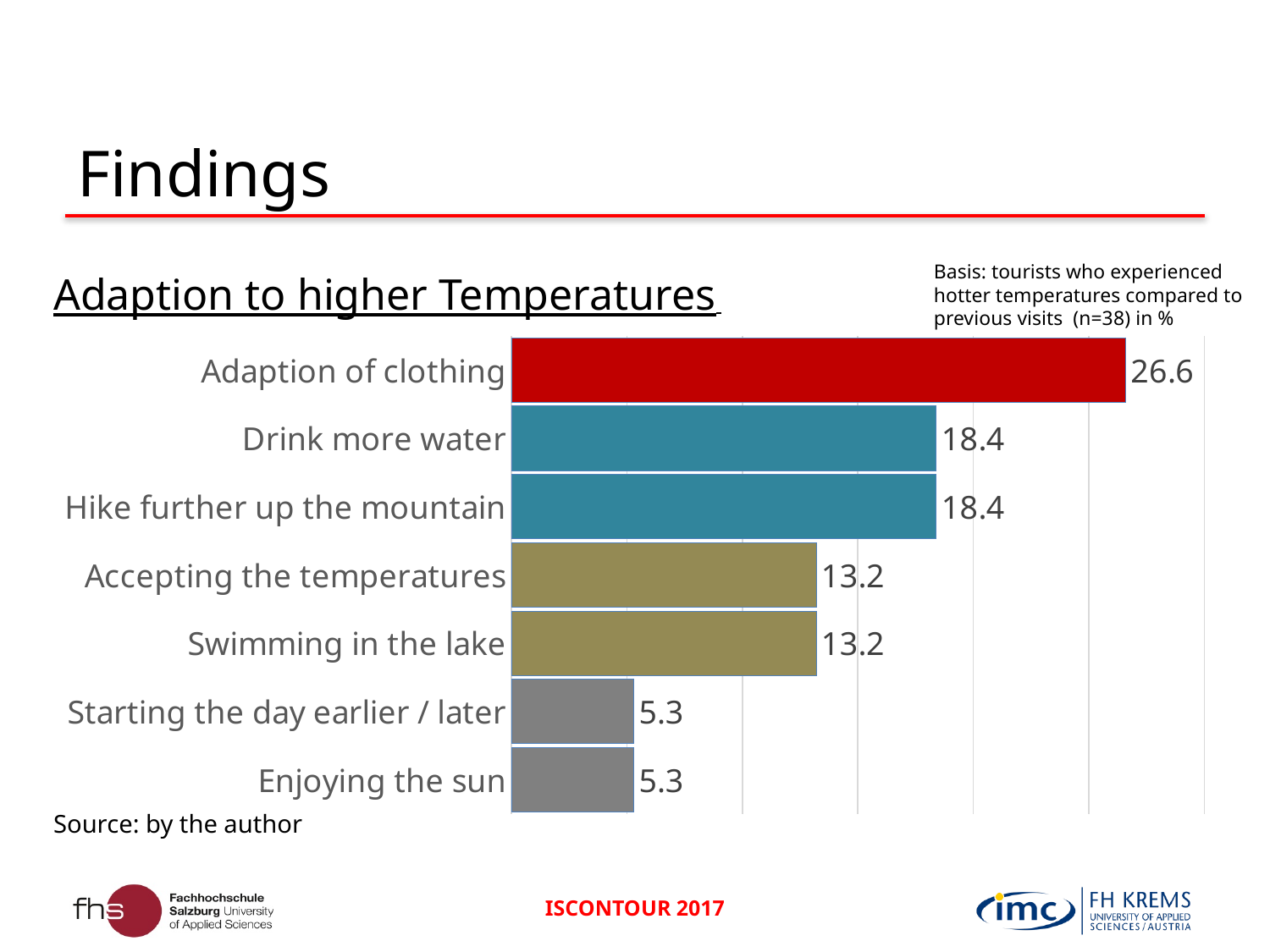
What kind of chart is shown on the slide? Bar chart What is the difference between the values for Swimming in the lake and Starting the day earlier / later? 7.9 What is the value for Enjoying the sun? 5.3 What is the value for Drink more water? 18.4 What colour is the bar for Adaption of clothing? Red Which is larger, the value for Hike further up the mountain or the value for Swimming in the lake? Hike further up the mountain What is the title of the chart? Adaption to higher Temperatures What is the value for Accepting the temperatures? 13.2 What is the value for Adaption of clothing? 26.6 How many categories are shown in the chart? 7 Which category has the highest value? Adaption of clothing What is the difference between the values for Adaption of clothing and Drink more water? 8.2